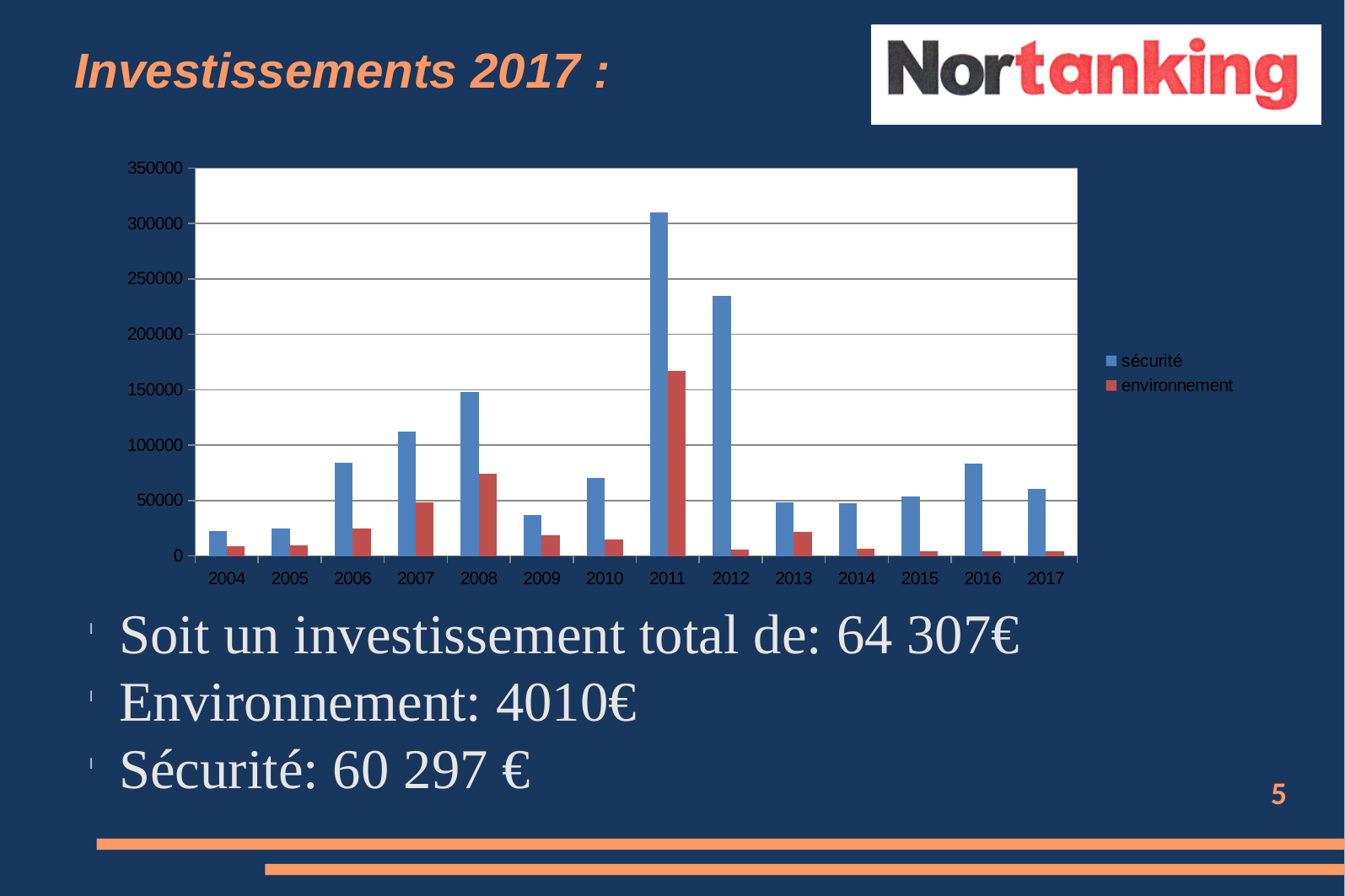
In which year is the sécurité value highest? 2011 Which colour represents the environnement series in the chart? red Is the sécurité value for 2012 greater or less than 200000? greater Which is larger, the sécurité value for 2008 or for 2006? 2008 How many years are shown on the x axis of the chart? 14 Do the sécurité values rise or fall from 2011 to 2015? fall Is the sécurité value for 2011 greater or less than 300000? greater Is the environnement value for 2008 greater or less than 50000? greater What kind of chart is shown on the slide? bar chart How many series does the legend list? 2 In which year is the environnement value highest? 2011